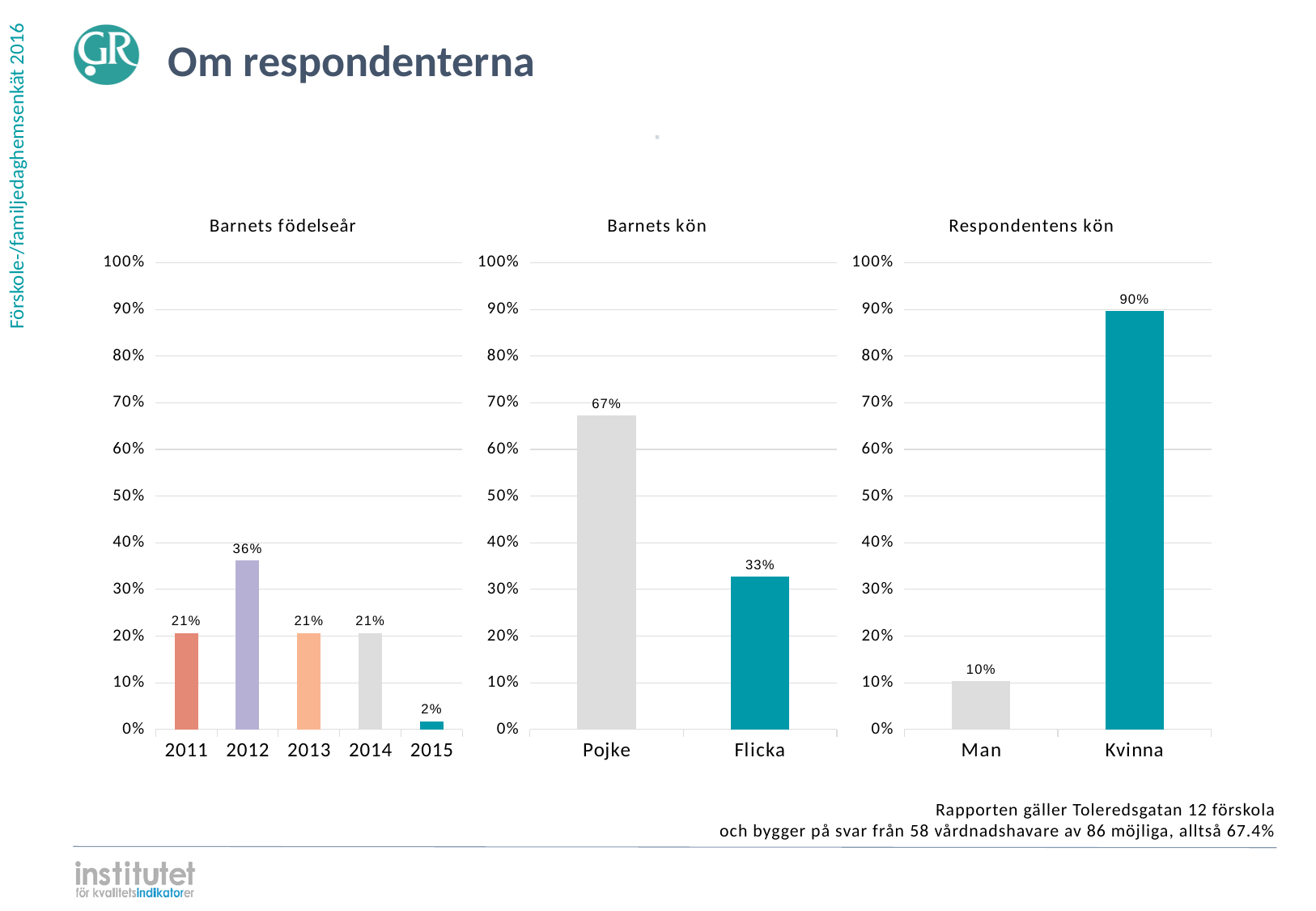
What kind of chart is the 'Respondentens kön' chart? Bar chart In the 'Barnets kön' chart, which is larger, Pojke or Flicka? Pojke In the 'Barnets födelseår' chart, how many birth-year categories are shown? 5 In the 'Barnets födelseår' chart, what is the value for 2012? 36% In the 'Barnets kön' chart, what is the difference between Pojke and Flicka? 34% What is the title of the chart on the left of the slide? Barnets födelseår In the 'Respondentens kön' chart, what is the value for Man? 10% In the 'Respondentens kön' chart, what is the value for Kvinna? 90% In the 'Barnets födelseår' chart, which birth year has the highest value? 2012 In the 'Barnets födelseår' chart, what is the difference between the values for 2012 and 2015? 34% In the 'Barnets kön' chart, what is the value for Pojke? 67% In the 'Barnets födelseår' chart, which birth year has the lowest value? 2015